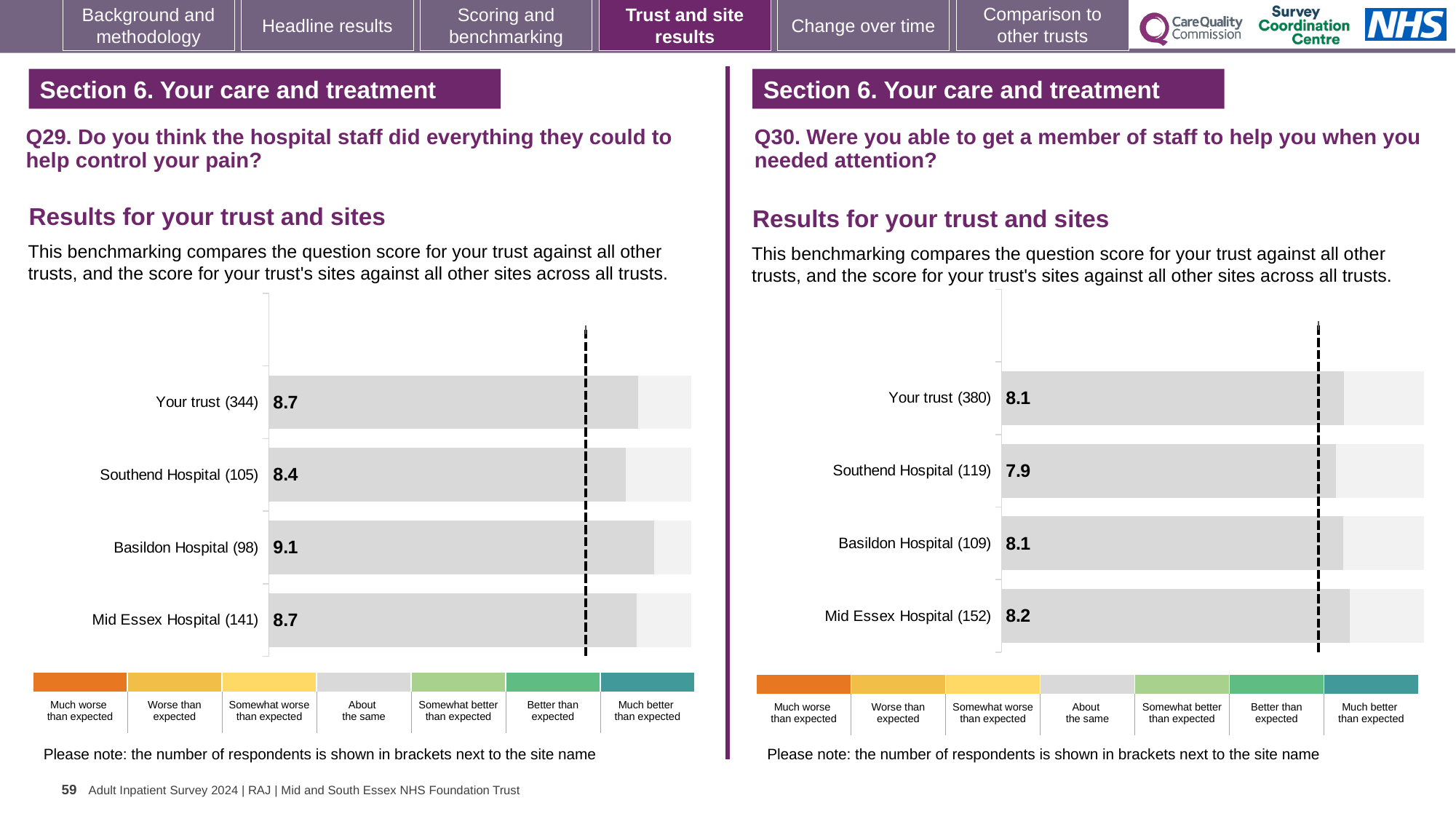
In the Q29 chart on the left, what is the score for Southend Hospital? 8.4 In the Q29 chart on the left, what is the difference between the scores for Basildon Hospital and Southend Hospital? 0.7 In the Q30 chart on the right, what is the score for Your trust? 8.1 In the Q30 chart on the right, which site or trust has the lowest score? Southend Hospital What kind of chart is used in the Q30 chart on the right? Bar chart In the Q30 chart on the right, what is the score for Mid Essex Hospital? 8.2 In the Q29 chart on the left, which site or trust has the lowest score? Southend Hospital How many bars are plotted in the Q29 chart on the left? 4 In the Q30 chart on the right, which site or trust has the highest score? Mid Essex Hospital In the Q29 chart on the left, what is the score for Basildon Hospital? 9.1 In the Q30 chart on the right, what is the difference between the scores for Mid Essex Hospital and Southend Hospital? 0.3 In the Q29 chart on the left, which site or trust has the highest score? Basildon Hospital